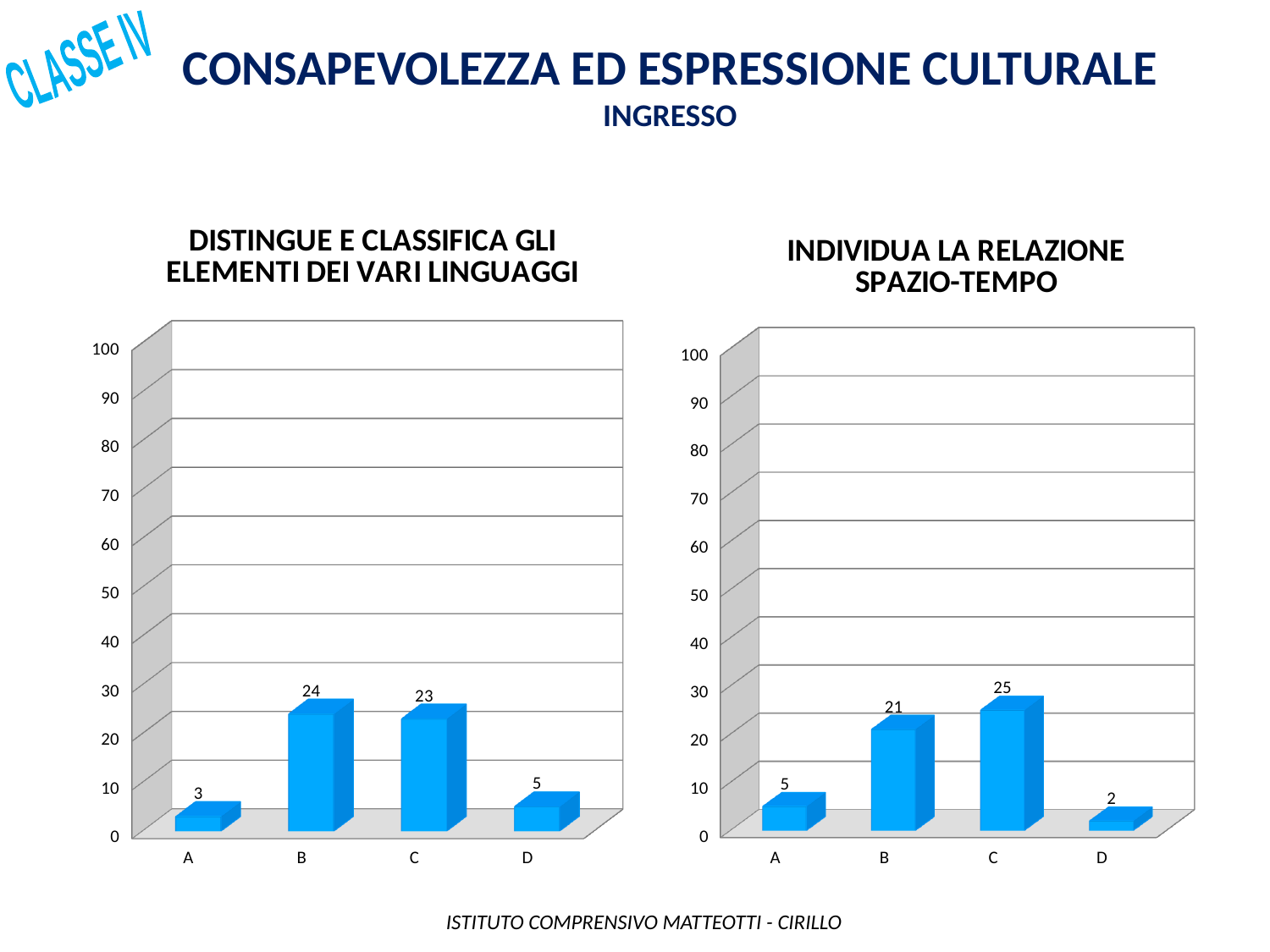
What kind of chart is the chart titled "DISTINGUE E CLASSIFICA GLI ELEMENTI DEI VARI LINGUAGGI"? Bar chart In the chart titled "DISTINGUE E CLASSIFICA GLI ELEMENTI DEI VARI LINGUAGGI", what is the difference between the values for B and D? 19 In the chart titled "DISTINGUE E CLASSIFICA GLI ELEMENTI DEI VARI LINGUAGGI", is the value for C greater or less than 30? less In the chart titled "INDIVIDUA LA RELAZIONE SPAZIO-TEMPO", which is larger, the value for B or the value for A? B In the chart titled "DISTINGUE E CLASSIFICA GLI ELEMENTI DEI VARI LINGUAGGI", what is the value for category A? 3 In the chart titled "INDIVIDUA LA RELAZIONE SPAZIO-TEMPO", what is the value for category D? 2 What is the maximum value shown on the vertical axis of the chart titled "INDIVIDUA LA RELAZIONE SPAZIO-TEMPO"? 100 In the chart titled "DISTINGUE E CLASSIFICA GLI ELEMENTI DEI VARI LINGUAGGI", which category has the lowest value? A In the chart titled "INDIVIDUA LA RELAZIONE SPAZIO-TEMPO", what is the difference between the values for C and A? 20 How many categories are shown in the chart titled "INDIVIDUA LA RELAZIONE SPAZIO-TEMPO"? 4 In the chart titled "INDIVIDUA LA RELAZIONE SPAZIO-TEMPO", which category has the highest value? C In the chart titled "DISTINGUE E CLASSIFICA GLI ELEMENTI DEI VARI LINGUAGGI", what is the value for category B? 24